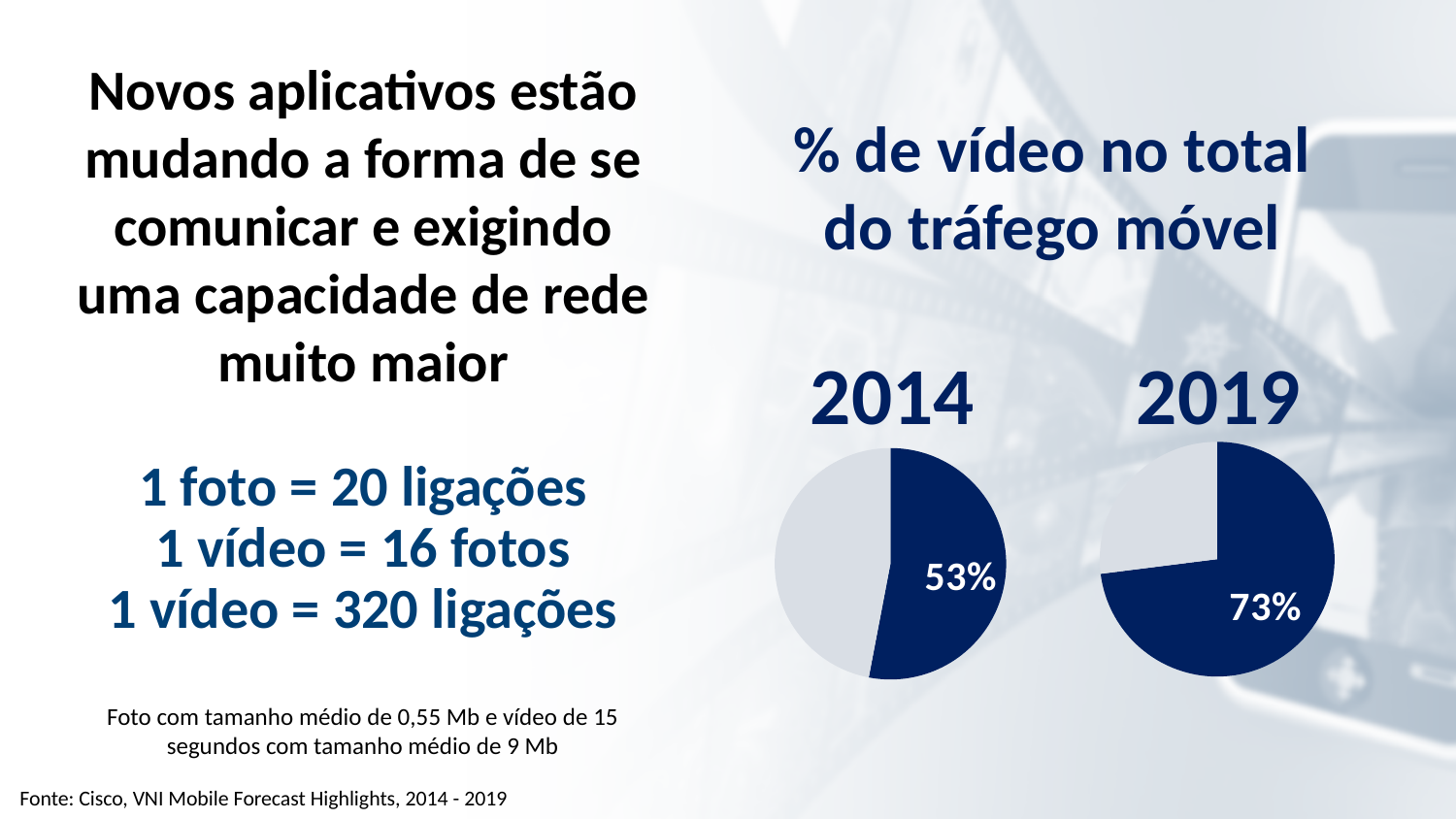
In the 2019 pie chart, what percentage of mobile traffic is video? 73% How many slices does each pie chart have? 2 What kind of charts are shown on the right side of the slide? Pie charts What colour is the labelled video slice in the pie charts? Dark blue What is the title above the pie charts? % de vídeo no total do tráfego móvel In the 2014 pie chart, is the video share greater or less than 50%? greater By how many percentage points does the video share in the 2019 pie chart exceed that in the 2014 pie chart? 20 percentage points How many pie charts are on the slide? 2 Which pie chart has the smaller labelled slice, 2014 or 2019? 2014 Which year's pie chart shows the larger share of video in mobile traffic, 2014 or 2019? 2019 Does the share of video in mobile traffic rise or fall from the 2014 pie chart to the 2019 pie chart? Rise In the 2014 pie chart, what percentage of mobile traffic is video? 53%